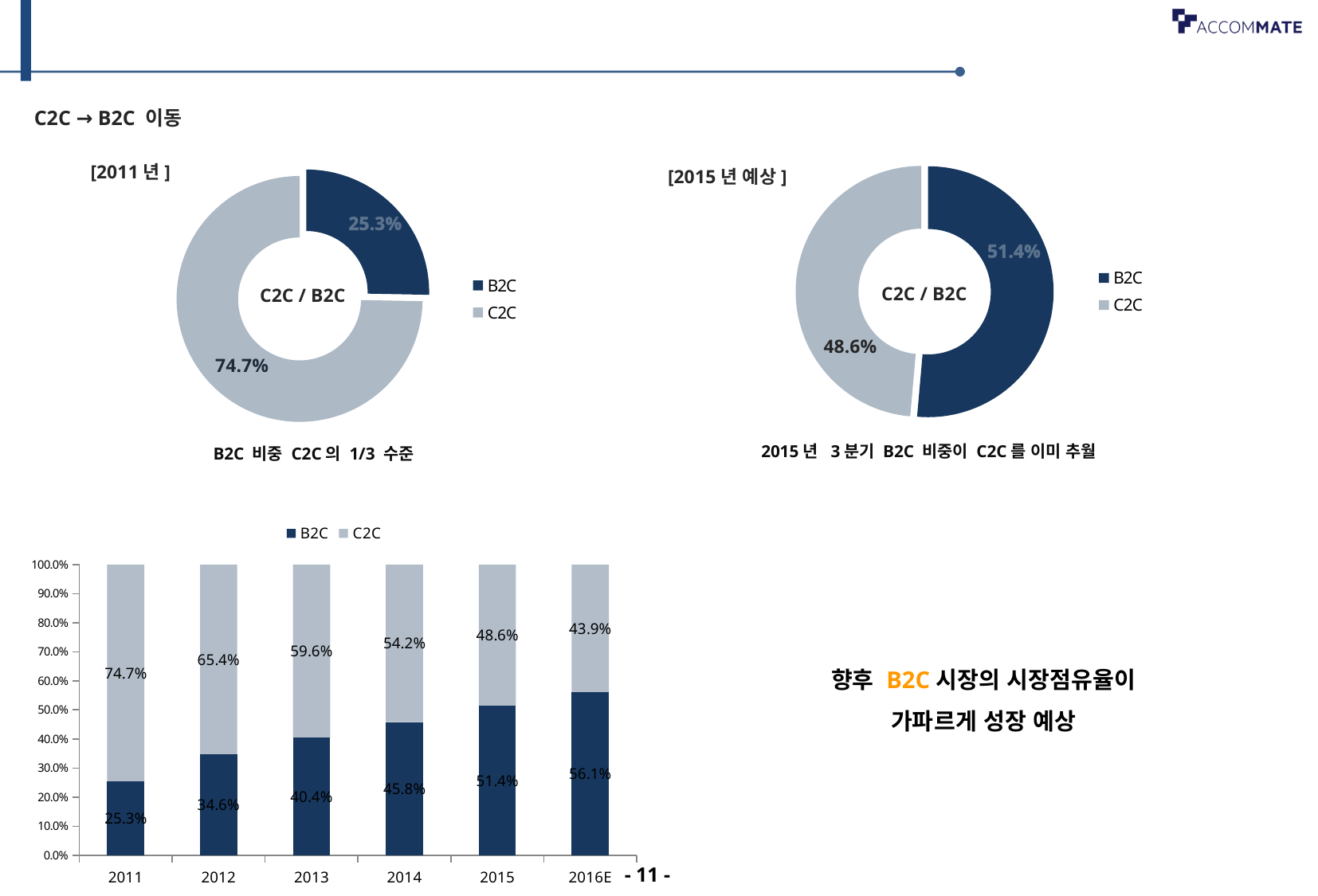
In the bottom stacked bar chart, which year has the lowest C2C value? 2016E In the bottom stacked bar chart, do the B2C values rise or fall from 2011 to 2016E? Rise In the [2011년] donut chart, what is the difference between the C2C and B2C shares? 49.4% In the [2011년] donut chart, what is the share for B2C? 25.3% In the bottom stacked bar chart, what is the C2C value for 2012? 65.4% In the [2015년 예상] donut chart, which slice is larger, B2C or C2C? B2C In the [2015년 예상] donut chart, what is the share for C2C? 48.6% In the bottom stacked bar chart, what is the B2C value for 2014? 45.8% In the bottom stacked bar chart, how many years are shown on the x axis? 6 In the bottom stacked bar chart, how many series does the legend list? 2 In the bottom stacked bar chart, what is the difference between the B2C value for 2016E and the B2C value for 2011? 30.8% What kind of chart is the bottom chart with years on the x axis? Stacked bar chart